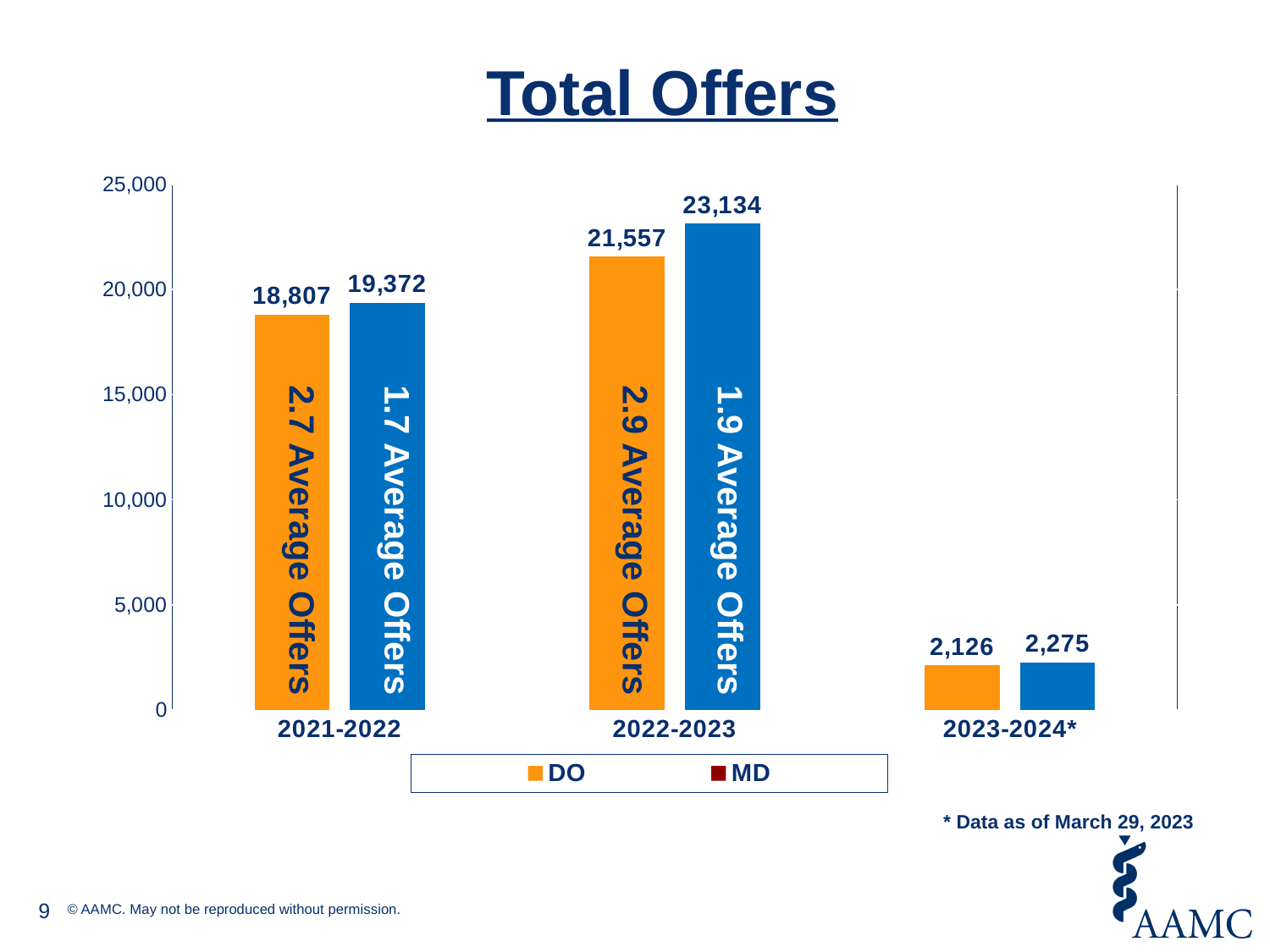
How many year categories are shown on the x axis? 3 What average offers figure is printed on the MD bar for 2022-2023? 1.9 Average Offers Which is larger in 2021-2022, the DO value or the MD value? MD What is the value for DO in 2023-2024*? 2,126 What kind of chart is shown on the slide? bar chart What is the difference between the MD and DO values in 2022-2023? 1,577 What is the title of the chart? Total Offers What is the value for MD in 2022-2023? 23,134 Which year has the lowest DO value? 2023-2024* Which year has the highest MD value? 2022-2023 What is the value for DO in 2021-2022? 18,807 How many series does the legend list? 2